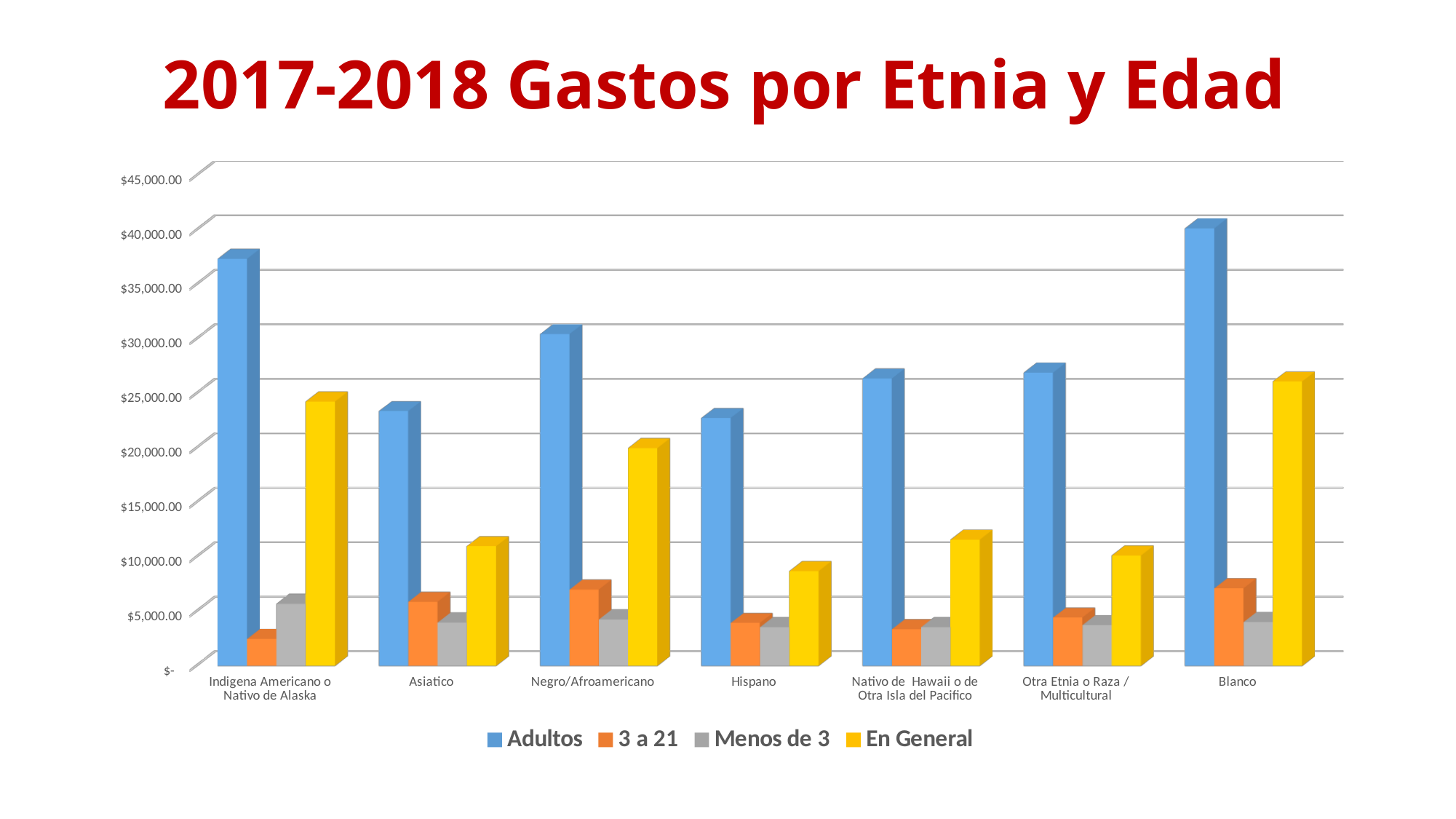
How many ethnic categories are shown along the x axis? 7 What is the title of the chart? 2017-2018 Gastos por Etnia y Edad Which series is shown in yellow in the legend? En General Which category has the lowest En General value? Hispano Is the Adultos value for Blanco greater or less than $35,000.00? greater Which category has the highest Adultos value? Blanco Is the En General value for Hispano greater or less than $10,000.00? less Is the Adultos value for Hispano greater or less than $25,000.00? less Which is larger, the Adultos value for Indigena Americano o Nativo de Alaska or the Adultos value for Asiatico? Indigena Americano o Nativo de Alaska Which is larger, the En General value for Negro/Afroamericano or the En General value for Asiatico? Negro/Afroamericano How many series does the legend list? 4 What kind of chart is shown on the slide? bar chart